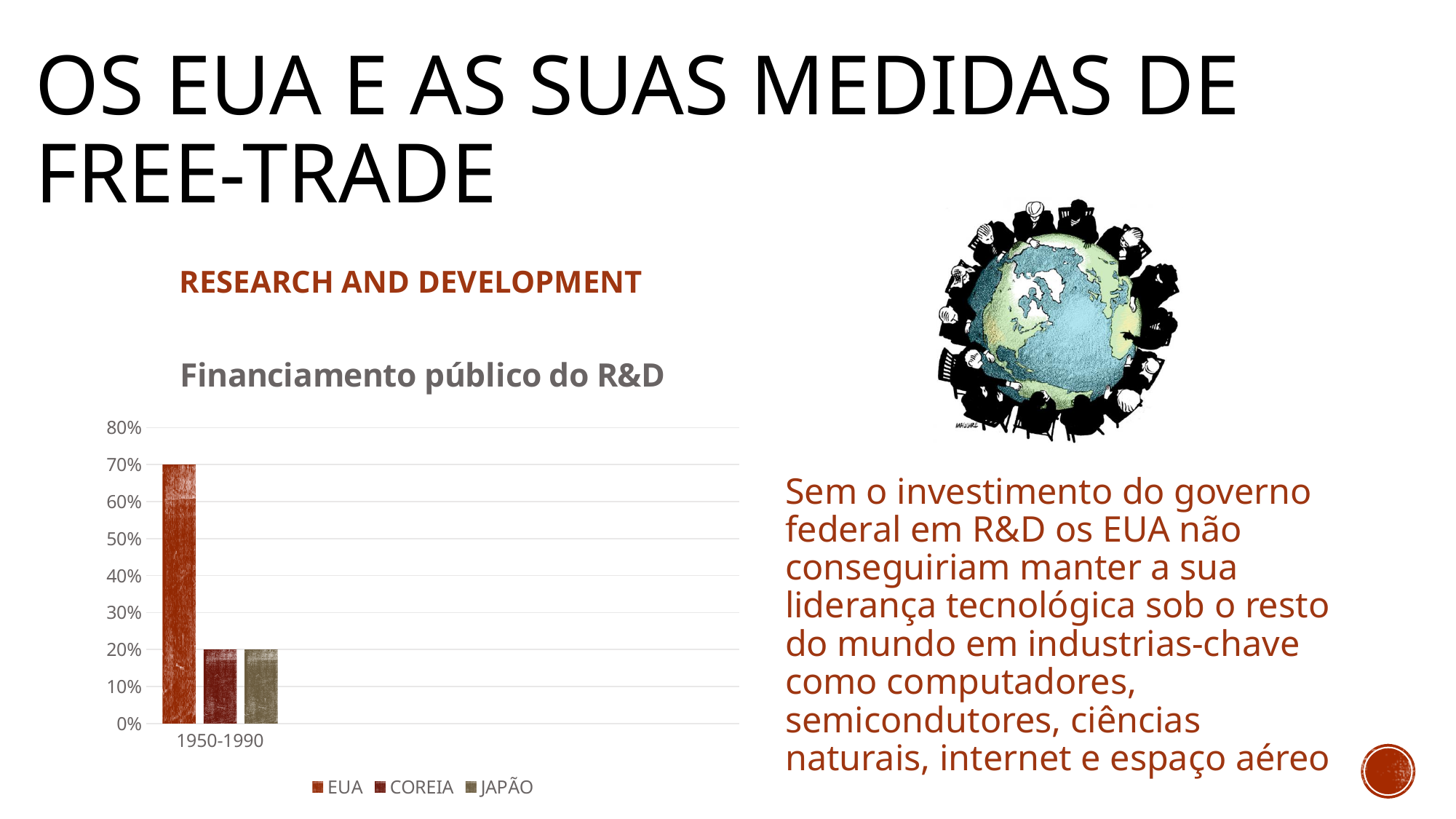
What type of chart is shown under the title "Financiamento público do R&D"? bar chart Which series are listed in the chart's legend? EUA, COREIA, JAPÃO Which series has the highest value in the chart? EUA What is the value for COREIA in the chart? 20% How many categories are shown on the x axis of the chart? 1 What is the value for EUA in the chart? 70% What is the difference between the values for EUA and COREIA in the chart? 50% What is the value for JAPÃO in the chart? 20% What is the category label on the x axis of the chart? 1950-1990 Is the value for EUA greater or less than 60%? greater How many series does the legend of the chart list? 3 What is the title of the chart on the slide? Financiamento público do R&D